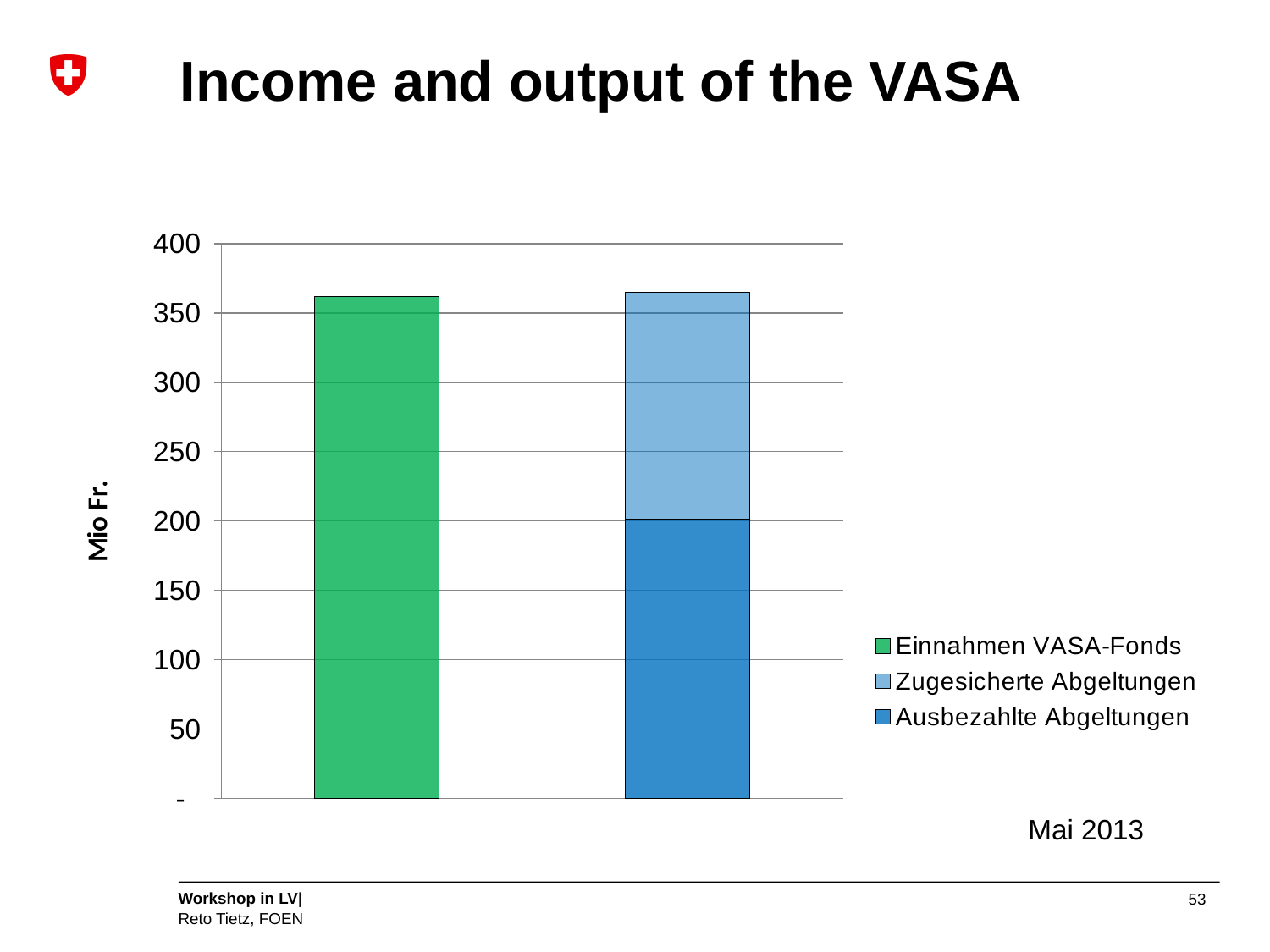
Is the value for Einnahmen VASA-Fonds greater or less than 350? greater What kind of chart is shown on the slide? bar chart Is the value for Einnahmen VASA-Fonds greater or less than 400? less What is the label on the vertical axis? Mio Fr. Is the total of the stacked bar (Ausbezahlte plus Zugesicherte Abgeltungen) greater or less than 350? greater Within the stacked bar, which segment is larger: Ausbezahlte Abgeltungen or Zugesicherte Abgeltungen? Ausbezahlte Abgeltungen Which legend entry is shown in green? Einnahmen VASA-Fonds How many bars are plotted in the chart? 2 How many series does the legend list? 3